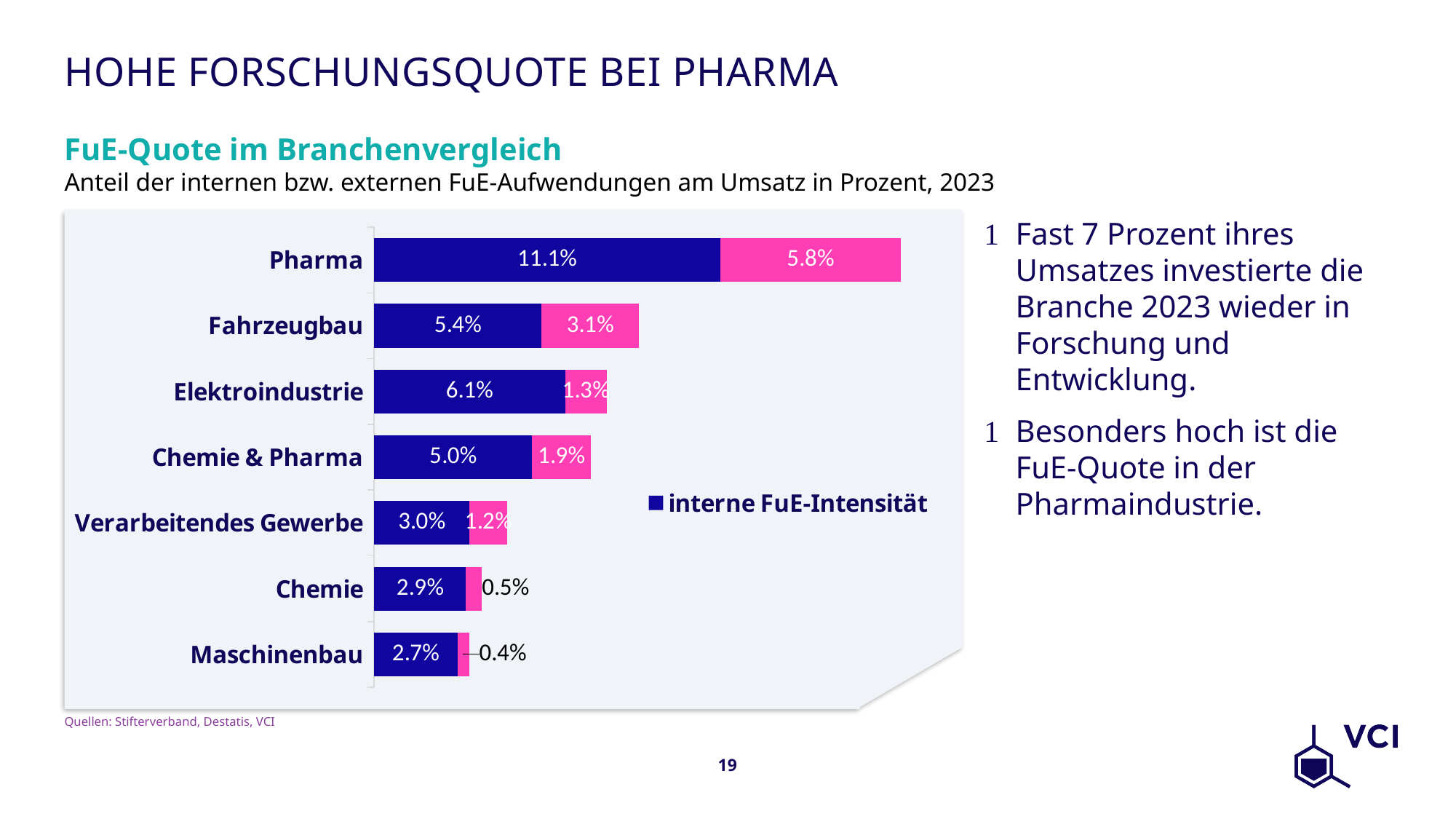
What is the difference between the interne FuE-Intensität of Pharma and Elektroindustrie? 5.0% Which is larger, the interne FuE-Intensität of Fahrzeugbau or of Elektroindustrie? Elektroindustrie What is the title of the chart? FuE-Quote im Branchenvergleich How many categories are shown in the chart? 7 What is the total of the stacked bar for Chemie & Pharma? 6.9% What is the interne FuE-Intensität value for Maschinenbau? 2.7% Which category has the highest interne FuE-Intensität? Pharma What is the interne FuE-Intensität value for Pharma? 11.1% What is the value of the pink segment for Fahrzeugbau? 3.1% Which category has the lowest value for the pink segment? Maschinenbau What kind of chart is shown on the slide? Stacked bar chart What is the total of the stacked bar for Pharma? 16.9%